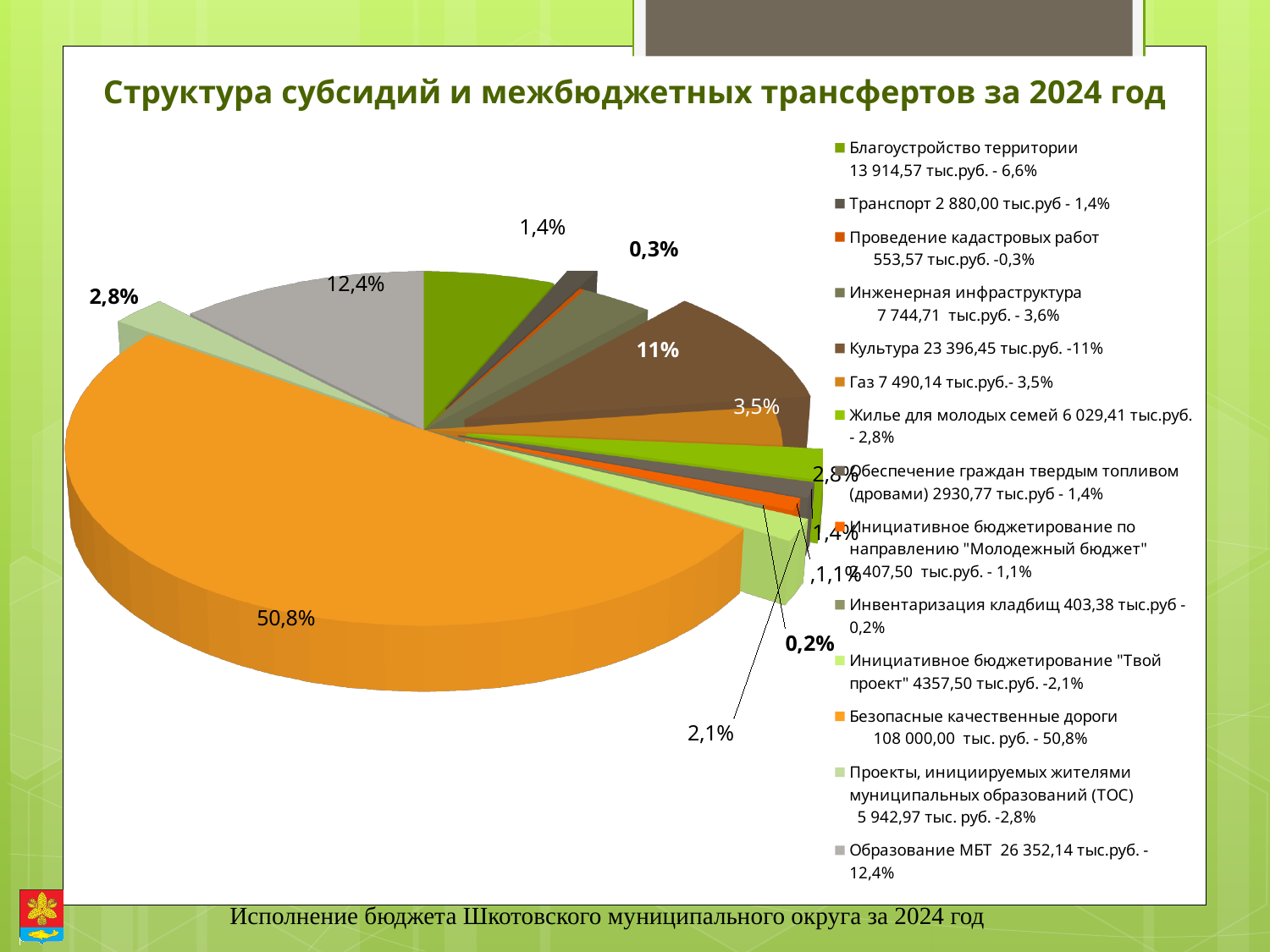
How many categories does the legend list? 14 What is the difference in percentage points between Образование МБТ (12,4%) and Культура (11%)? 1,4% What percentage is shown for Газ? 3,5% Which is larger, the share for Культура or the share for Образование МБТ? Образование МБТ What kind of chart is shown on the slide? pie chart What share of the pie does Безопасные качественные дороги account for? 50,8% What share of the pie does Образование МБТ account for? 12,4% Which category has the largest share of the pie? Безопасные качественные дороги Which category has the smallest share of the pie? Инвентаризация кладбищ What is the title of the chart? Структура субсидий и межбюджетных трансфертов за 2024 год What is the amount shown for Культура in the legend? 23 396,45 тыс.руб. What is the amount shown for Благоустройство территории in the legend? 13 914,57 тыс.руб.